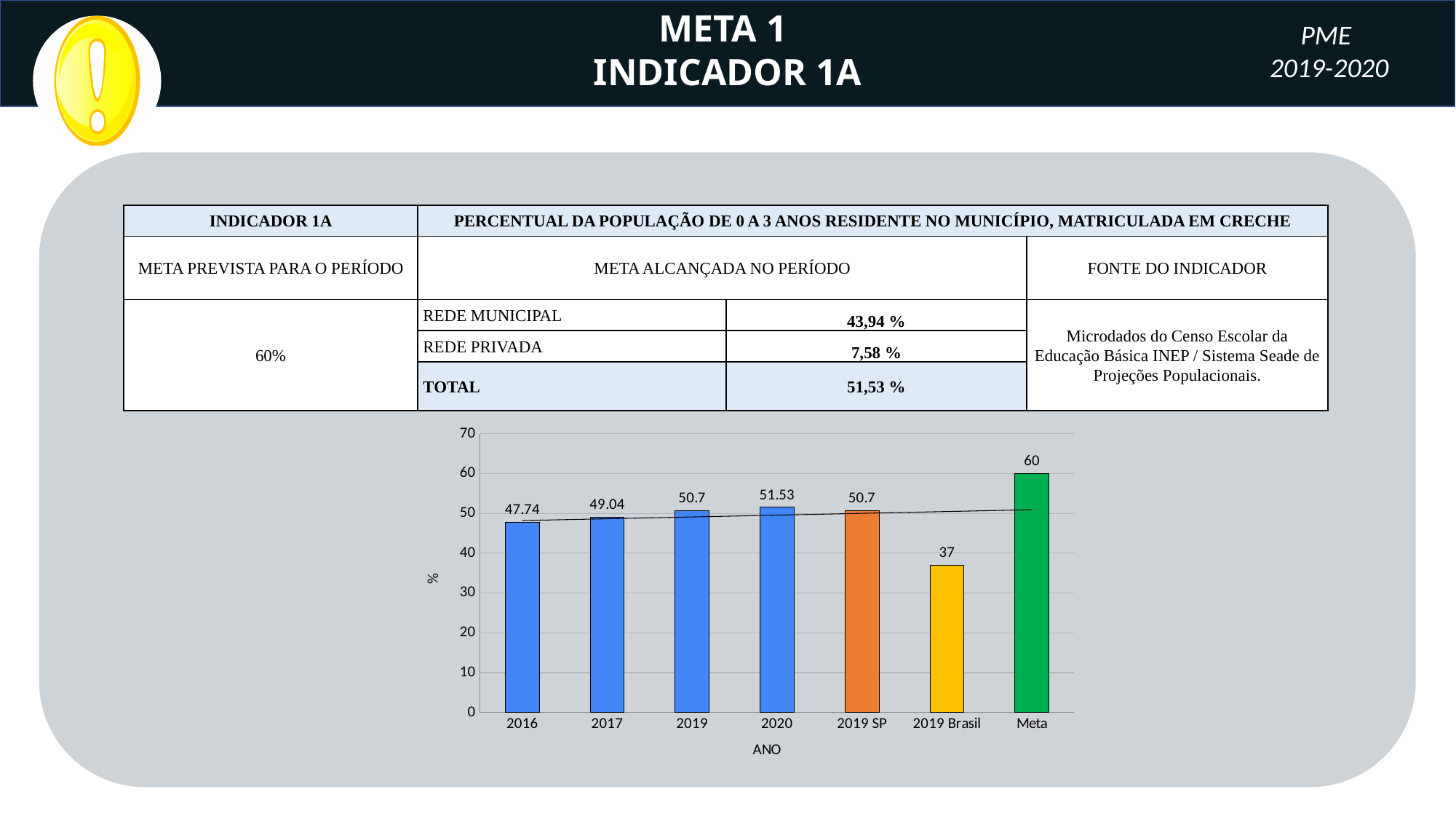
Which is larger in the bar chart, the value for 2017 or the value for 2019? 2019 What is the value for 2016 in the bar chart? 47.74 Which category has the lowest value in the bar chart? 2019 Brasil What is the value for 2020 in the bar chart? 51.53 Do the values rise or fall from 2016 to 2020 in the bar chart? rise Which category has the highest value in the bar chart? Meta What is the value for 2019 Brasil in the bar chart? 37 How many bars are shown in the bar chart? 7 What kind of chart is shown on the slide? bar chart What is the value for Meta in the bar chart? 60 What is the difference between the Meta value and the 2020 value in the bar chart? 8.47 What is the difference between the 2019 SP value and the 2019 Brasil value in the bar chart? 13.7